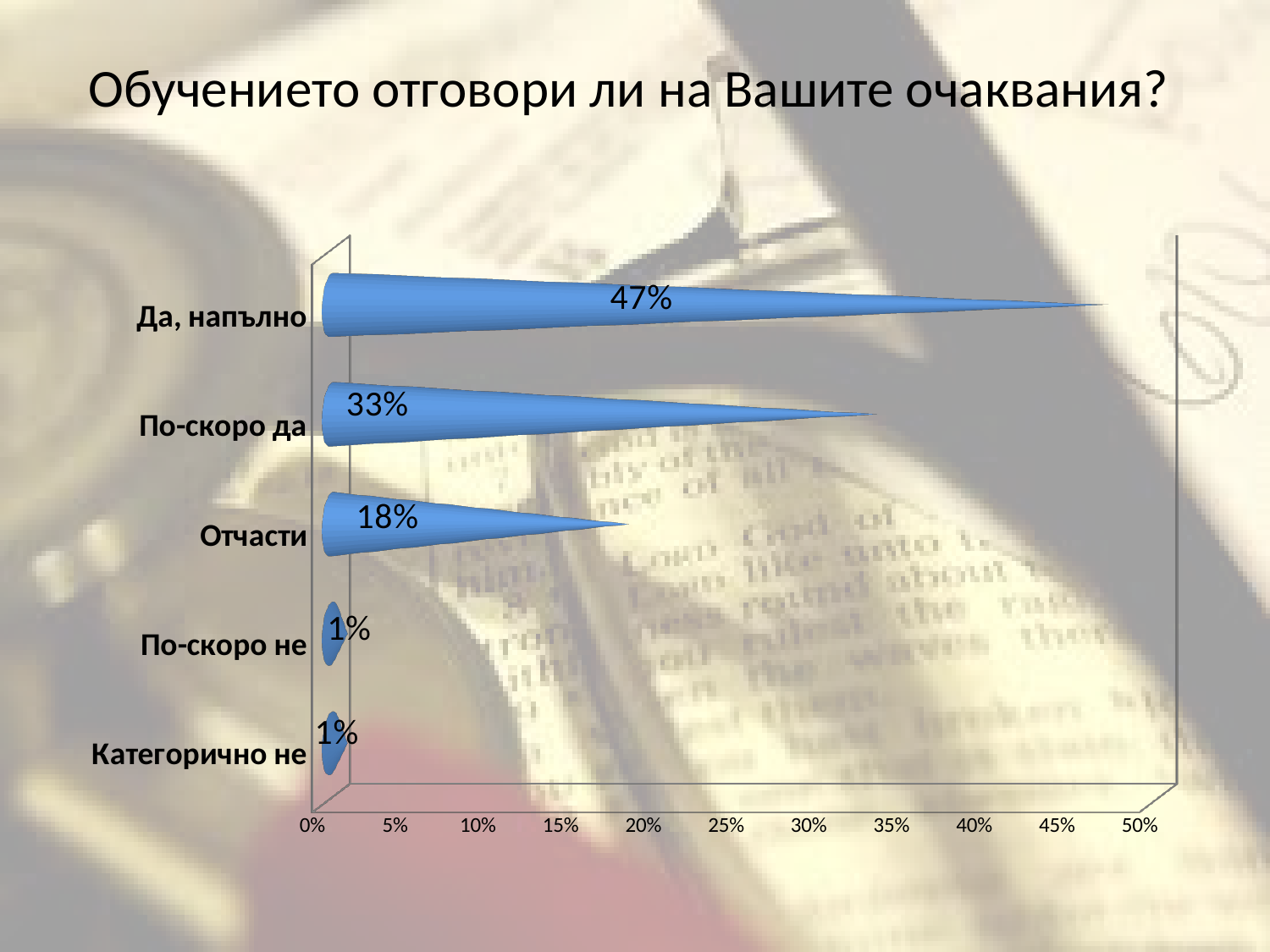
Is the value for "Да, напълно" greater or less than 40%? greater What kind of chart is shown on the slide? bar chart What is the value for "Да, напълно"? 47% What is the difference between the values for "По-скоро да" and "Отчасти"? 15% Which is larger, the value for "Отчасти" or the value for "По-скоро не"? Отчасти Which category has the highest value? Да, напълно What is the difference between the values for "Да, напълно" and "По-скоро да"? 14% What is the value for "По-скоро да"? 33% What is the value for "Категорично не"? 1% How many categories are shown in the chart? 5 What is the value for "Отчасти"? 18% What is the title of the slide? Обучението отговори ли на Вашите очаквания?